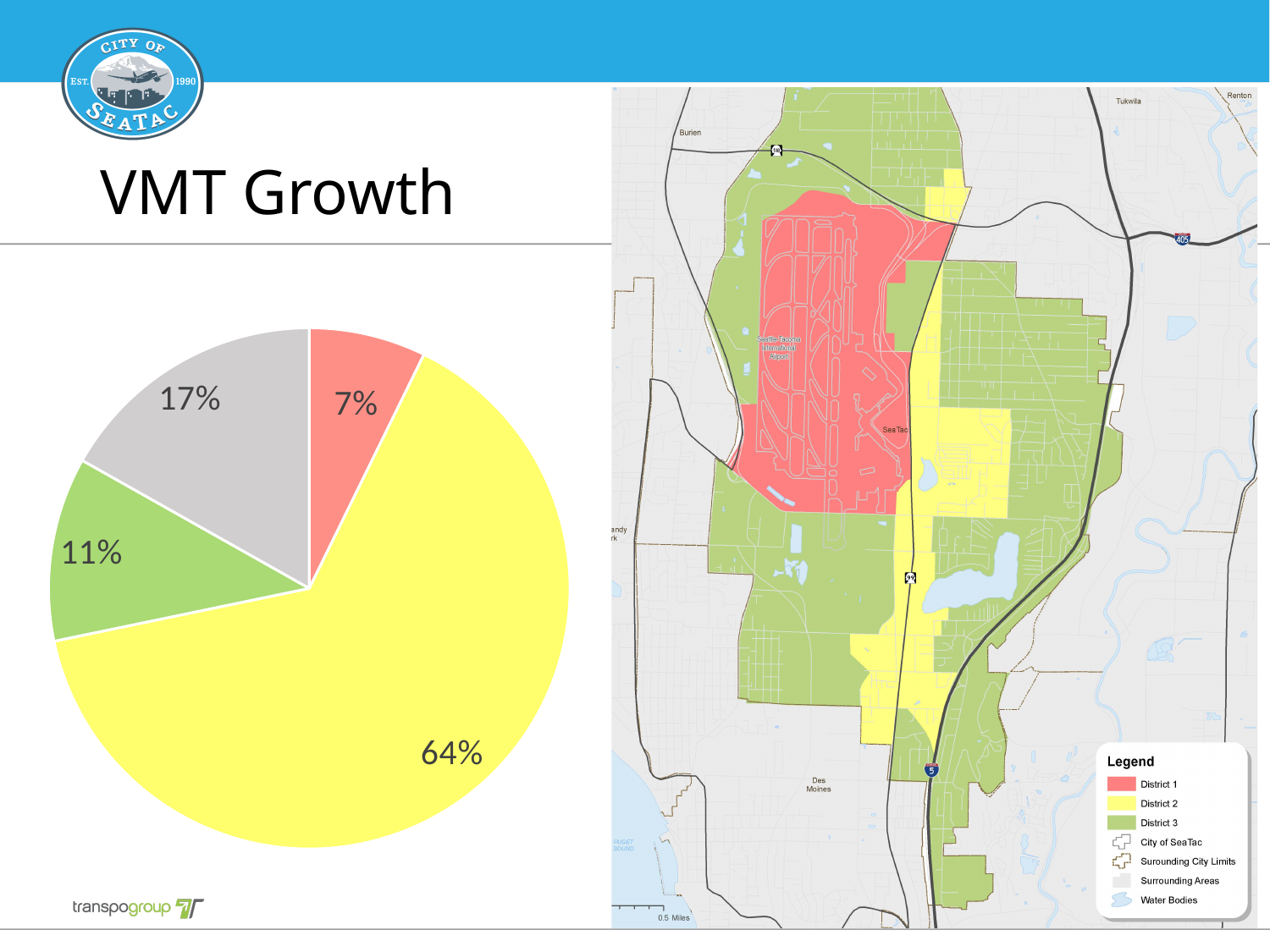
Which is larger in the pie chart, the gray slice or the green slice? the gray slice What percentage is shown on the red slice of the pie chart? 7% What percentage is shown on the green slice of the pie chart? 11% What percentage is shown on the yellow slice of the pie chart? 64% What is the title of the slide containing the pie chart? VMT Growth Which slice of the pie chart is the largest? the yellow slice (64%) What is the difference between the yellow slice and the red slice of the pie chart? 57% Which slice of the pie chart is the smallest? the red slice (7%) What kind of chart is shown on the slide? pie chart What is the difference between the gray slice and the green slice of the pie chart? 6% How many slices does the pie chart have? 4 What percentage is shown on the gray slice of the pie chart? 17%